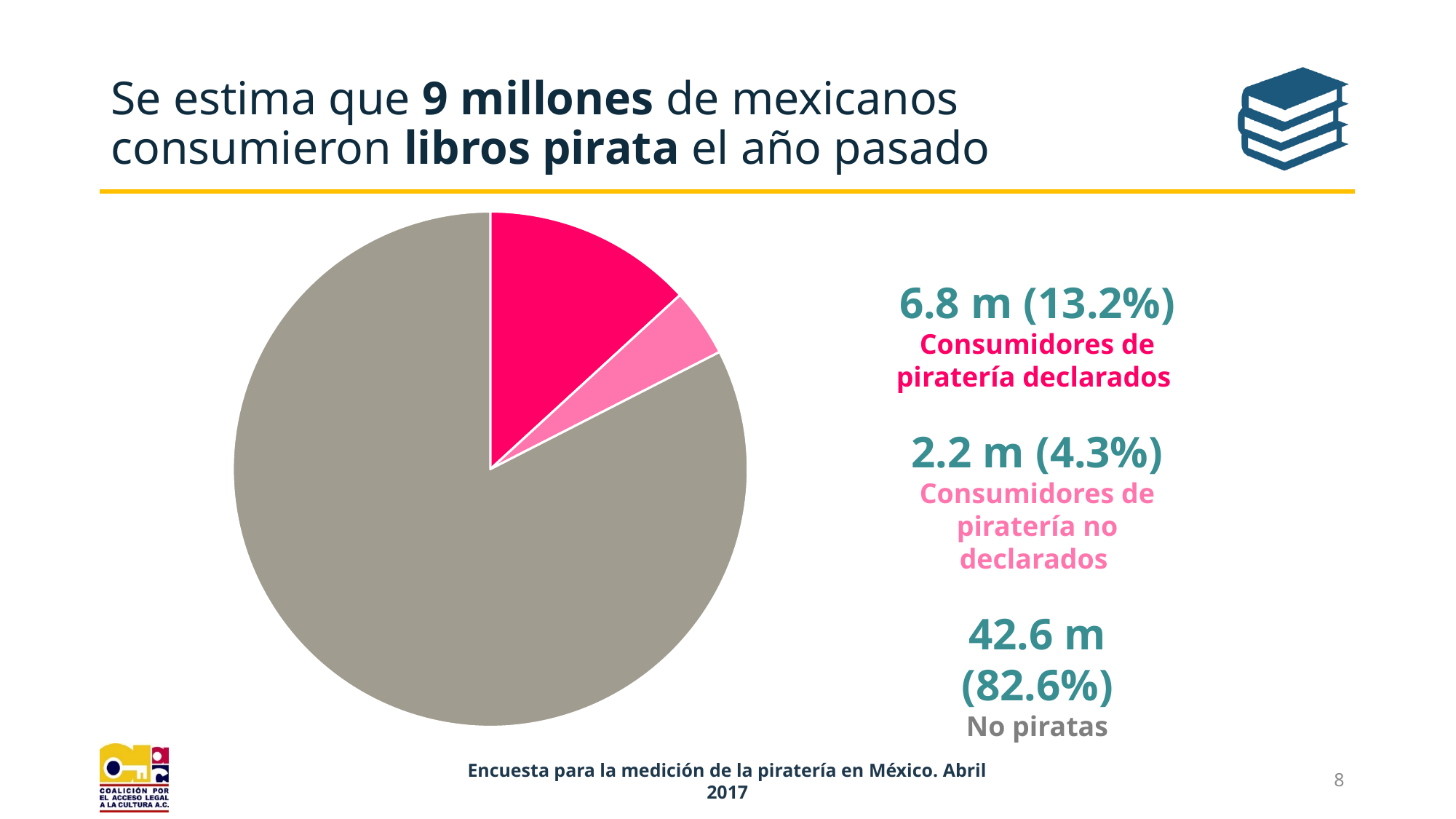
Which category has the largest slice of the pie? No piratas How many slices does the pie chart have? 3 What share of the pie is 'Consumidores de piratería no declarados'? 4.3% What share of the pie is 'No piratas'? 82.6% What kind of chart is shown on the slide? pie chart What is the value in millions for 'Consumidores de piratería no declarados'? 2.2 m What is the difference in percentage points between 'Consumidores de piratería declarados' and 'Consumidores de piratería no declarados'? 8.9 What share of the pie is 'Consumidores de piratería declarados'? 13.2% What is the value in millions for 'Consumidores de piratería declarados'? 6.8 m Which category has the smallest slice of the pie? Consumidores de piratería no declarados What is the value in millions for 'No piratas'? 42.6 m Which colour is used for the 'No piratas' slice? grey